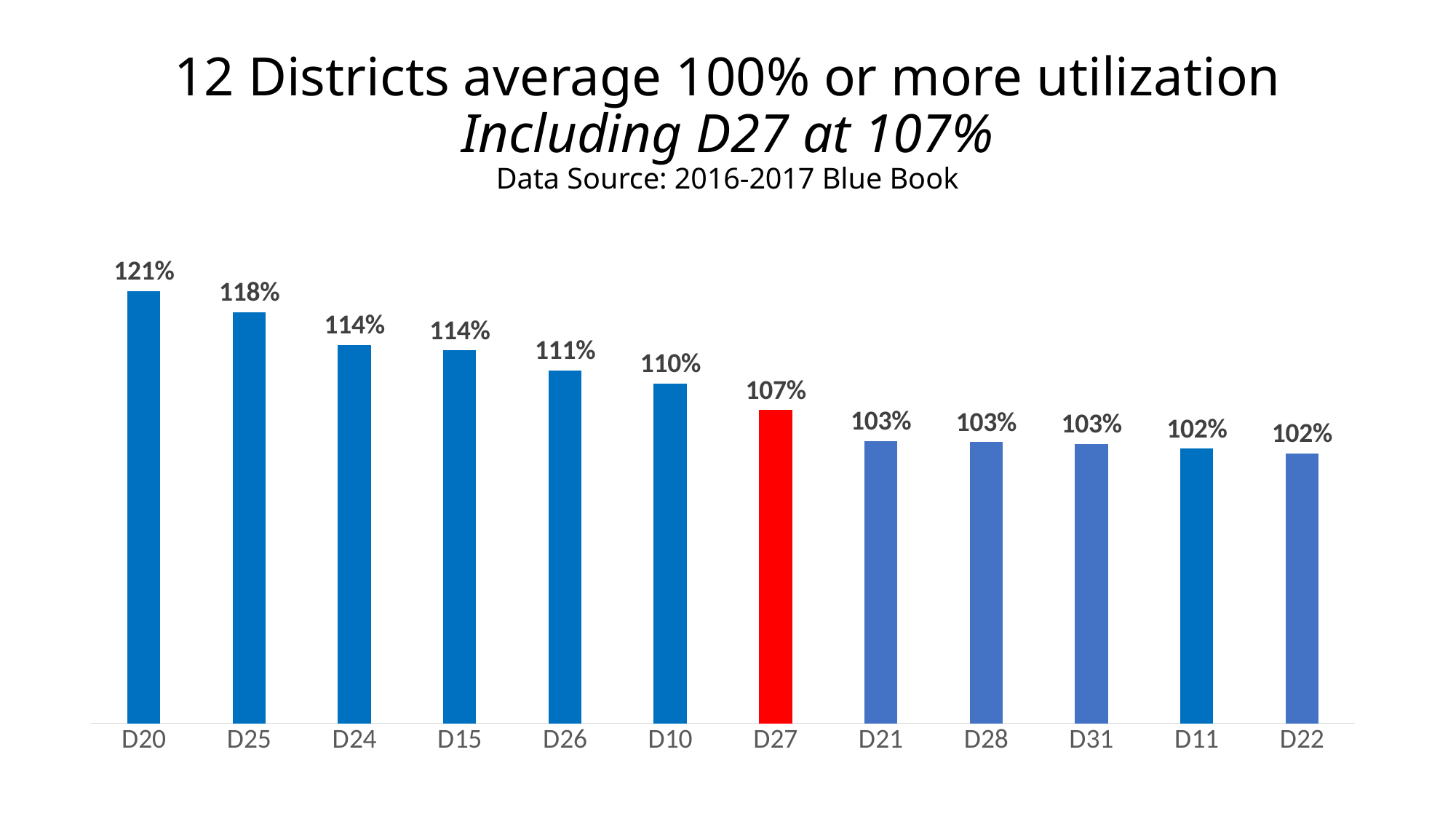
What is the difference between the utilization of D25 and D10? 8% Which has a higher utilization, D24 or D21? D24 Which district's bar is coloured red? D27 What is the utilization value for D27? 107% Do the values rise or fall from left to right along the x axis? Fall What is the utilization value for D26? 111% What kind of chart is shown on the slide? Bar chart Which district has the highest utilization? D20 What is the utilization value for D20? 121% What is the difference between the utilization of D20 and D27? 14% How many districts are shown in the chart? 12 Which has a higher utilization, D27 or D25? D25